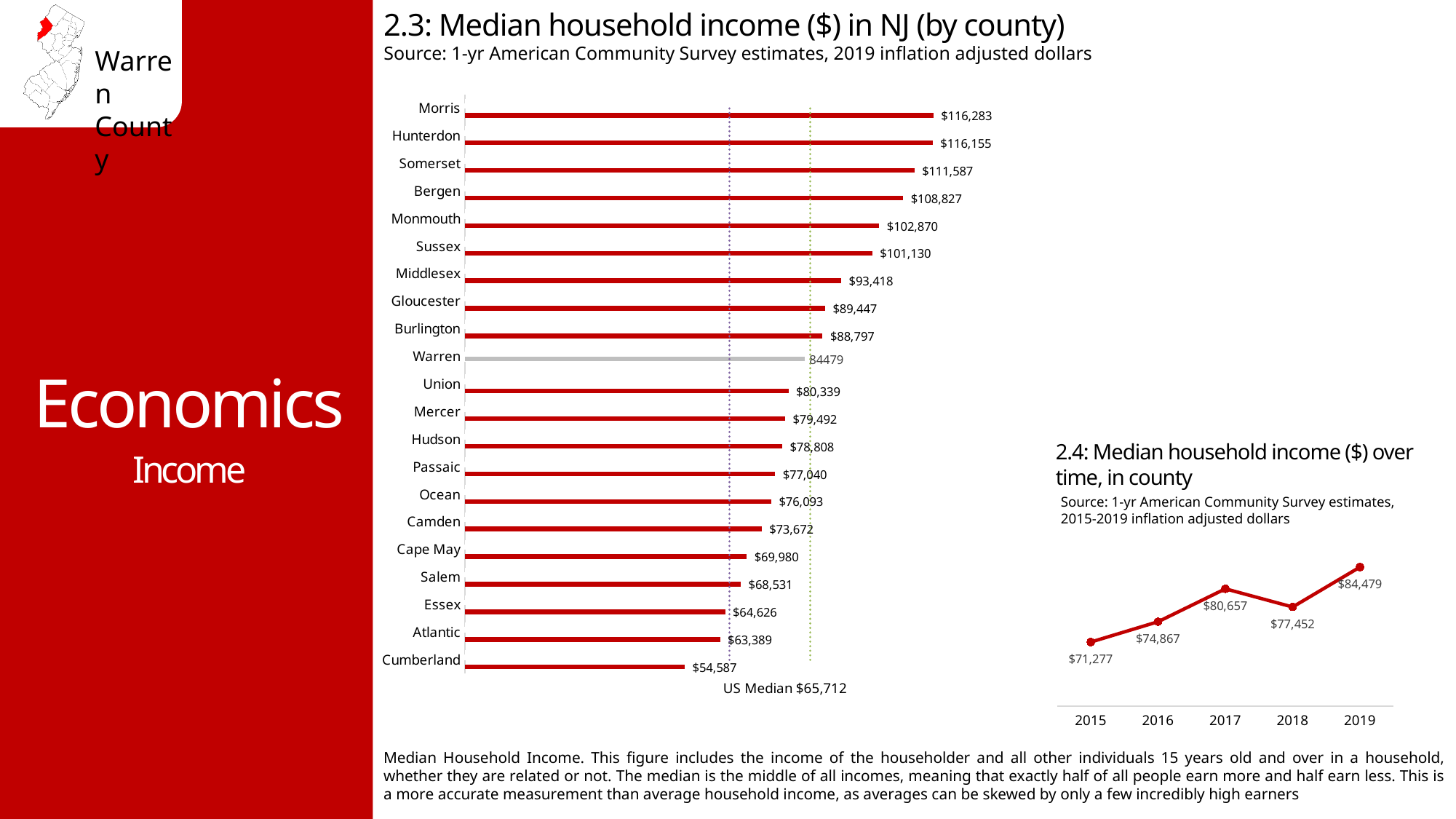
In the chart '2.3: Median household income ($) in NJ (by county)', which county has the lowest median household income? Cumberland What kind of chart is '2.3: Median household income ($) in NJ (by county)'? Bar chart In the chart '2.4: Median household income ($) over time, in county', which year has the highest median household income? 2019 In the chart '2.4: Median household income ($) over time, in county', what is the difference between the 2019 and 2015 values? $13,202 In the chart '2.3: Median household income ($) in NJ (by county)', what value is shown for Warren? 84479 What kind of chart is '2.4: Median household income ($) over time, in county'? Line chart In the chart '2.3: Median household income ($) in NJ (by county)', what is the median household income for Morris? $116,283 How many counties are shown in the chart '2.3: Median household income ($) in NJ (by county)'? 21 In the chart '2.3: Median household income ($) in NJ (by county)', what US Median value is noted below the bars? $65,712 In the chart '2.4: Median household income ($) over time, in county', what is the value for 2017? $80,657 In the chart '2.3: Median household income ($) in NJ (by county)', which has a higher median household income, Bergen or Monmouth? Bergen In the chart '2.3: Median household income ($) in NJ (by county)', what is the difference between the values for Morris and Cumberland? $61,696